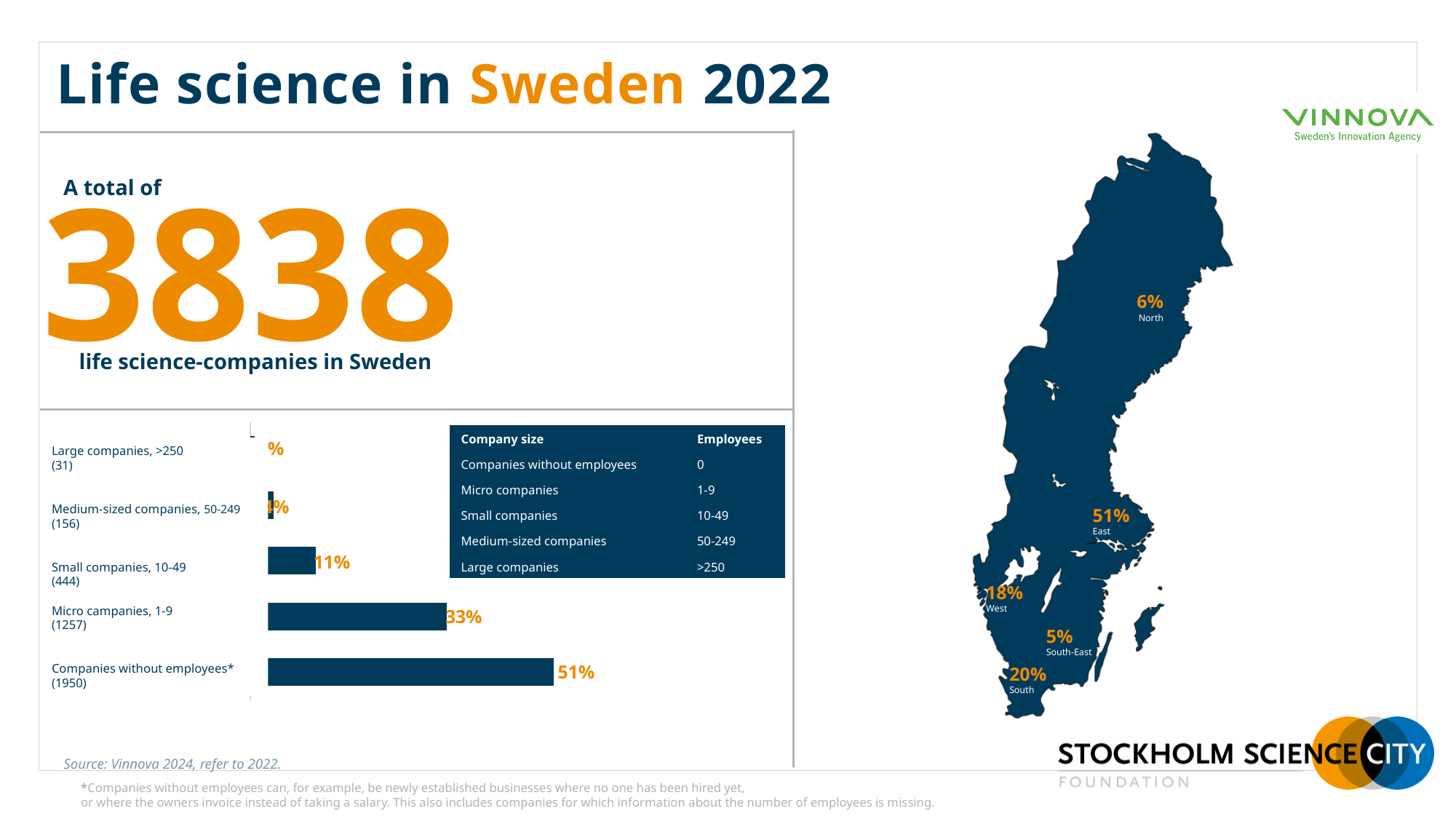
How many company-size categories are shown in the bar chart? 5 In the bar chart, what percentage is shown for Companies without employees? 51% Which company-size category has the smallest share in the bar chart? Large companies, >250 On the map of Sweden, which region has the highest share of life science companies? East According to the bar chart labels, how many Micro companies (1-9 employees) are there? 1257 In the bar chart, which has a larger share: Small companies, 10-49 or Micro companies, 1-9? Micro companies, 1-9 In the bar chart, what percentage is shown for Small companies, 10-49? 11% What kind of chart is used to show the distribution of life science companies by company size? Bar chart In the bar chart, what is the difference in percentage points between Micro companies and Small companies? 22 percentage points Which company-size category has the largest share in the bar chart? Companies without employees In the bar chart, what is the difference in percentage points between Companies without employees and Micro companies? 18 percentage points In the bar chart, what percentage is shown for Micro companies, 1-9? 33%